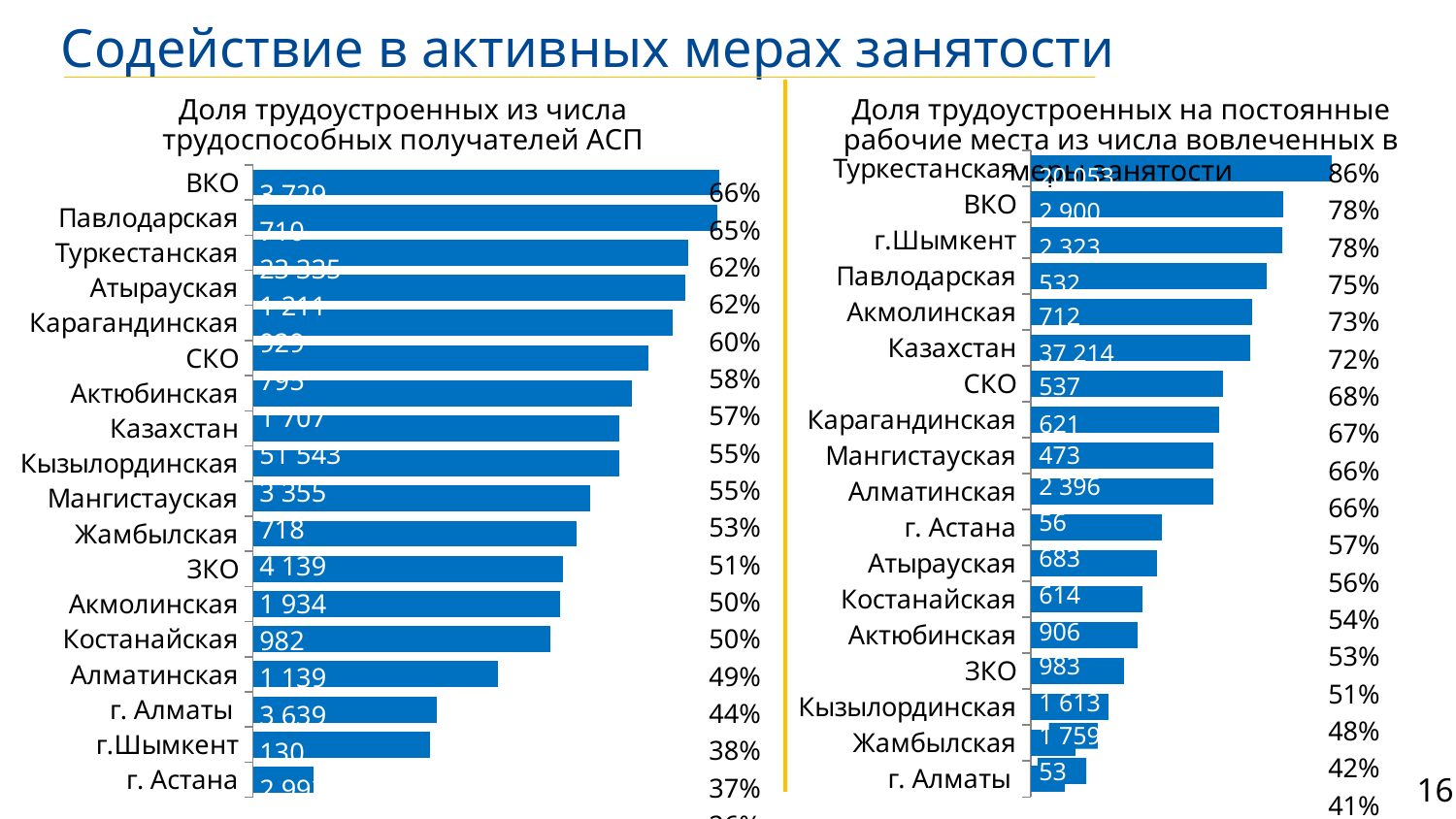
On the left chart, what is the percentage shown for ВКО? 66% On the left chart, what number is printed inside the bar for ЗКО? 4 139 On the right chart, what number is printed inside the bar for Казахстан? 37 214 On the left chart, which region has the highest percentage? ВКО On the right chart, which has a higher percentage, Павлодарская or Акмолинская? Павлодарская On the right chart, which region has the highest percentage? Туркестанская What type of chart is used on the left side of the slide? Bar chart On the right chart, which category has the lowest percentage? г. Алматы How many categories are shown on the right chart? 18 On the right chart, what is the percentage shown for Туркестанская? 86% On the right chart, what is the percentage shown for Казахстан? 72% On the right chart, what is the difference in percentage points between Туркестанская and г. Алматы? 45